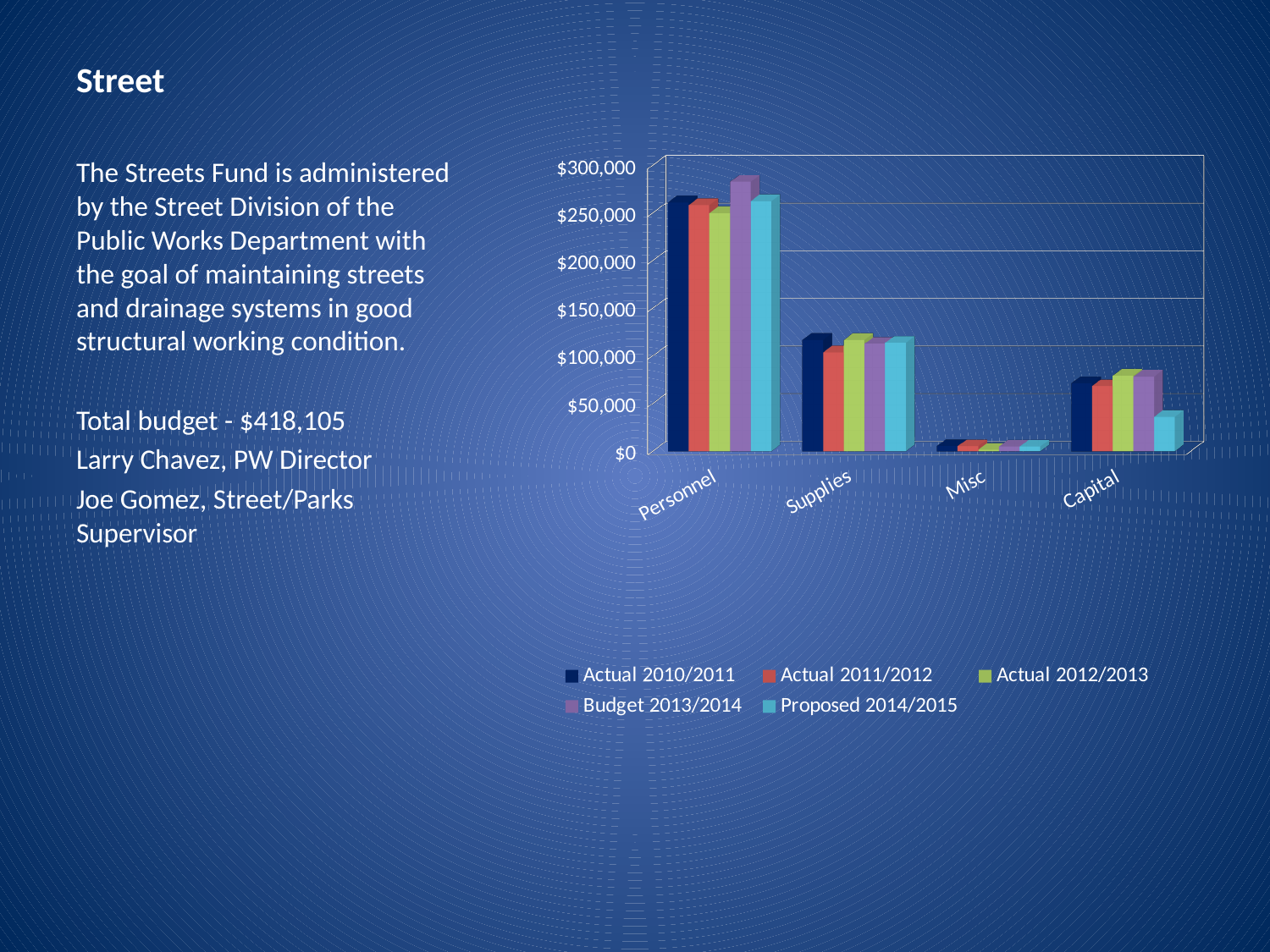
Which series in the legend is shown in purple? Budget 2013/2014 Is the Actual 2012/2013 value for Capital greater or less than $50,000? greater How many series does the chart's legend list? 5 Which category has the lowest values in the chart? Misc What kind of chart is shown on the slide? Bar chart For Personnel, which is larger: the Budget 2013/2014 value or the Proposed 2014/2015 value? Budget 2013/2014 Is the Proposed 2014/2015 value for Capital greater or less than $50,000? less For Actual 2010/2011, which category has the larger value: Supplies or Capital? Supplies How many categories are shown on the x axis of the chart? 4 Is the Budget 2013/2014 value for Personnel greater or less than $250,000? greater Which category has the highest values in the chart? Personnel